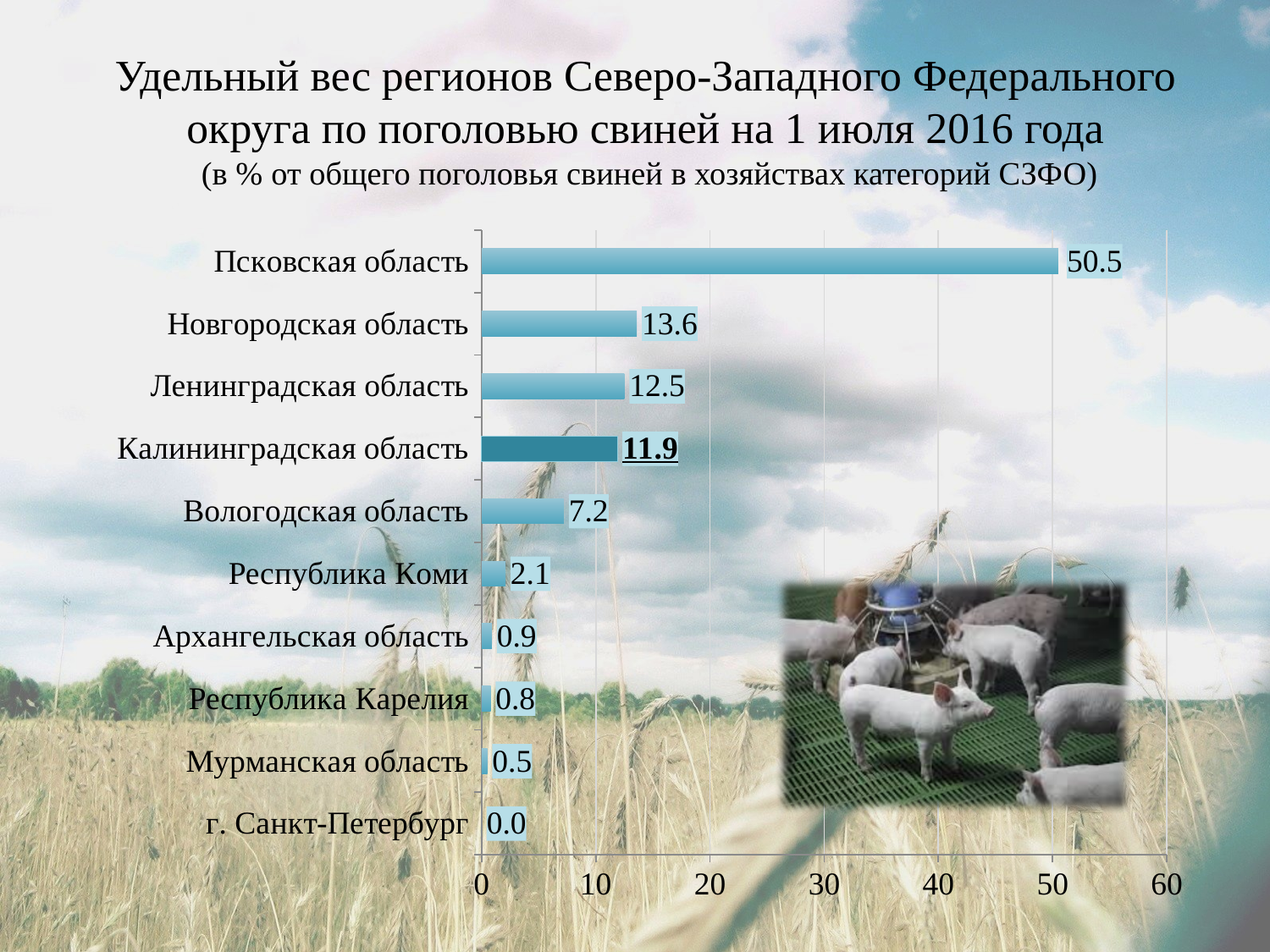
What is the difference between the values for Псковская область and Новгородская область? 36.9 What is the value for Калининградская область? 11.9 What is the value for Вологодская область? 7.2 What is the difference between the values for Новгородская область and Ленинградская область? 1.1 What is the value for Псковская область? 50.5 Which region has the lowest value? г. Санкт-Петербург How many regions are shown in the chart? 10 Which bar is drawn in a darker shade of blue than the others? Калининградская область Is the value for Псковская область greater or less than 40? greater Which is larger, the value for Республика Коми or the value for Архангельская область? Республика Коми Which region has the highest value? Псковская область What kind of chart is shown on the slide? bar chart